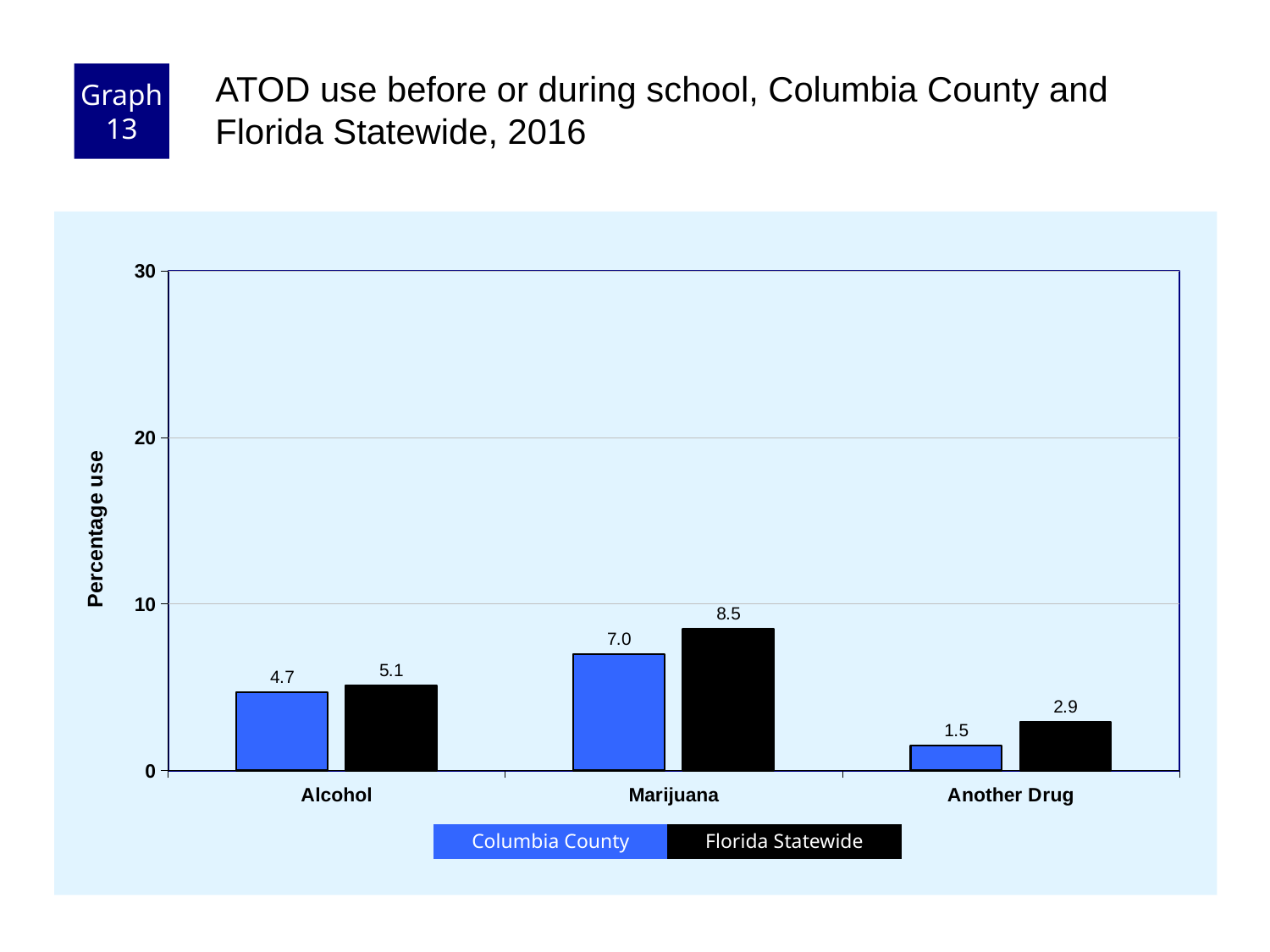
What is the difference between the Florida Statewide and Columbia County values for Another Drug? 1.4 What is the Florida Statewide value for Another Drug? 2.9 Which category has the lowest Columbia County value? Another Drug Which category has the highest Florida Statewide value? Marijuana What kind of chart is shown on the slide? bar chart Is the Florida Statewide value for Marijuana greater or less than 10? less How many series does the legend list? 2 What is the Columbia County value for Marijuana? 7.0 What is the Columbia County value for Alcohol? 4.7 How many categories are shown on the x axis? 3 Which is larger for Alcohol, the Columbia County value or the Florida Statewide value? Florida Statewide What is the difference between the Florida Statewide and Columbia County values for Marijuana? 1.5